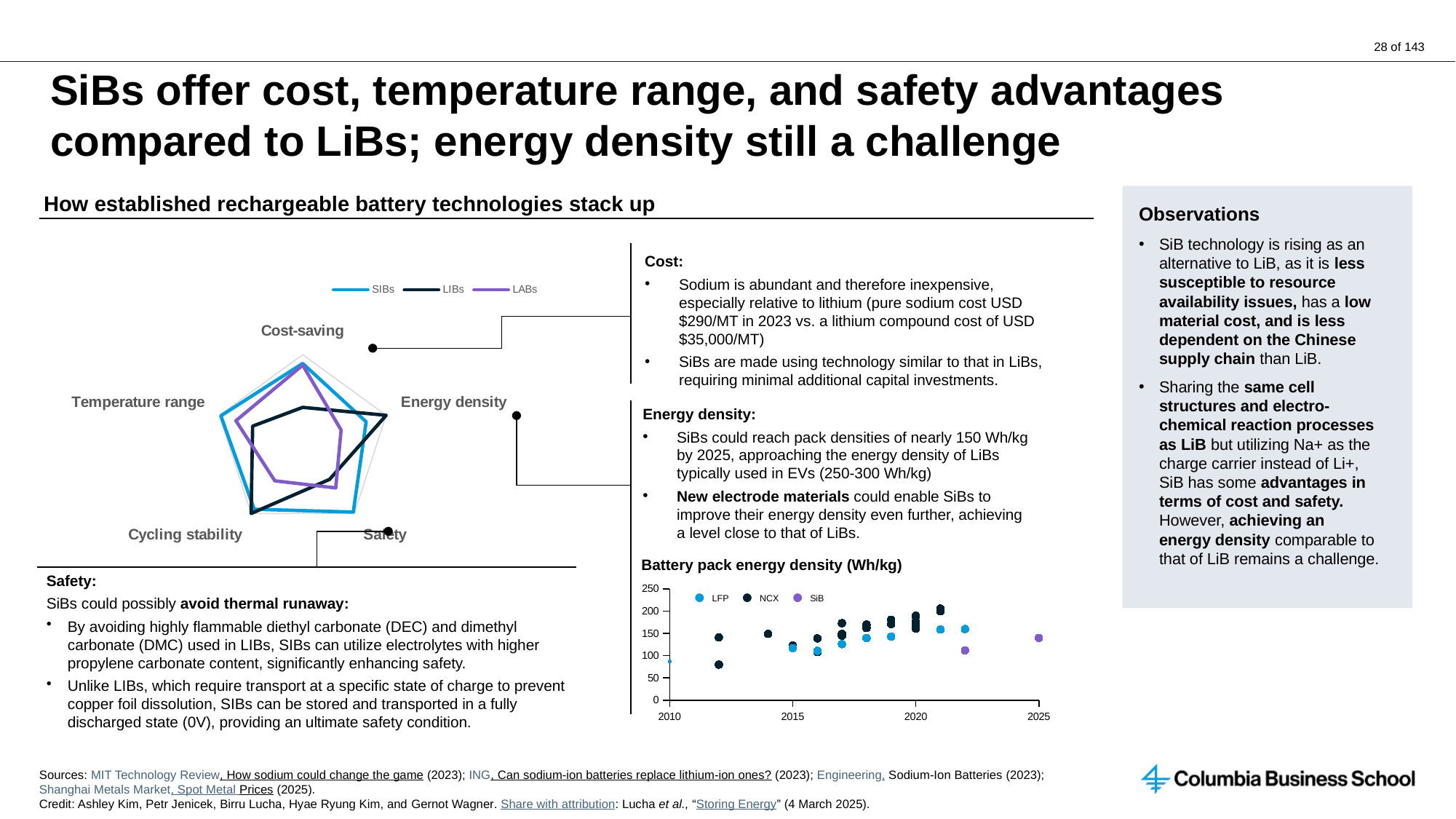
In the 'Battery pack energy density (Wh/kg)' chart, is the SiB value for 2025 greater or less than 100? greater How many series does the legend of the 'Battery pack energy density (Wh/kg)' chart list? 3 How many series does the legend of the radar chart 'How established rechargeable battery technologies stack up' list? 3 In the radar chart 'How established rechargeable battery technologies stack up', which series scores lowest on Energy density? LABs In the 'Battery pack energy density (Wh/kg)' chart, is the highest NCX value around 2021 greater or less than 150? greater What kind of chart is the 'How established rechargeable battery technologies stack up' chart? radar chart What are the legend entries of the 'Battery pack energy density (Wh/kg)' chart? LFP, NCX, SiB In the radar chart 'How established rechargeable battery technologies stack up', which series scores highest on Energy density? LIBs What kind of chart is the 'Battery pack energy density (Wh/kg)' chart? scatter chart How many axes (categories) does the radar chart 'How established rechargeable battery technologies stack up' have? 5 In the radar chart 'How established rechargeable battery technologies stack up', which series scores highest on Cycling stability? LIBs In the radar chart 'How established rechargeable battery technologies stack up', which series scores highest on Temperature range? SIBs